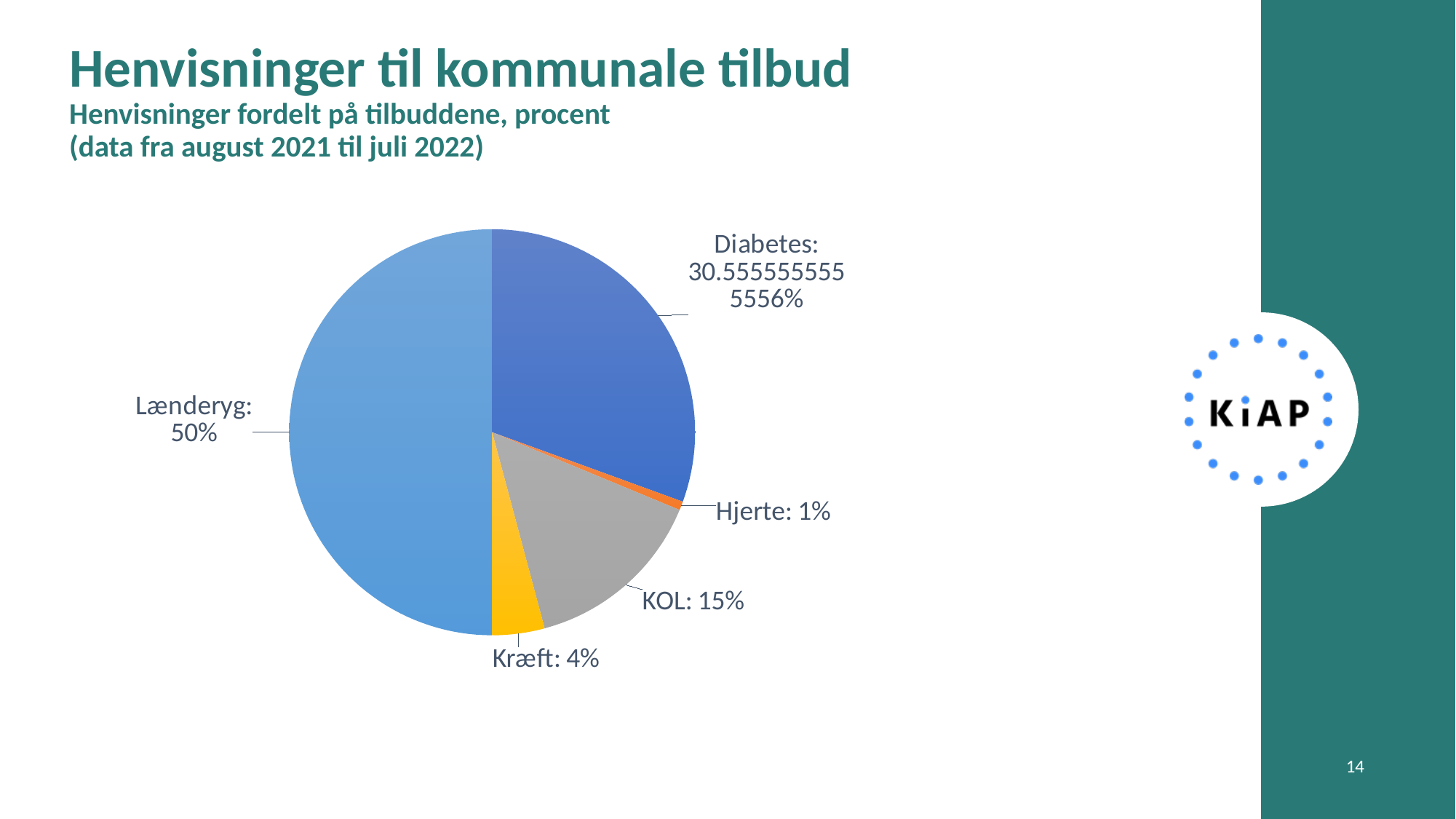
Which is larger, KOL or Kræft? KOL What is the difference between the values for Lænderyg and KOL? 35% What is the value shown for Diabetes? 30.5555555555556% What is the subtitle of the chart on the slide? Henvisninger fordelt på tilbuddene, procent (data fra august 2021 til juli 2022) Which category has the smallest slice of the pie? Hjerte What is the value for Hjerte? 1% What kind of chart is shown on the slide? pie chart Which category has the largest slice of the pie? Lænderyg What is the value for Kræft? 4% What share of the pie does Lænderyg have? 50% What is the value for KOL? 15% How many slices does the pie chart have? 5